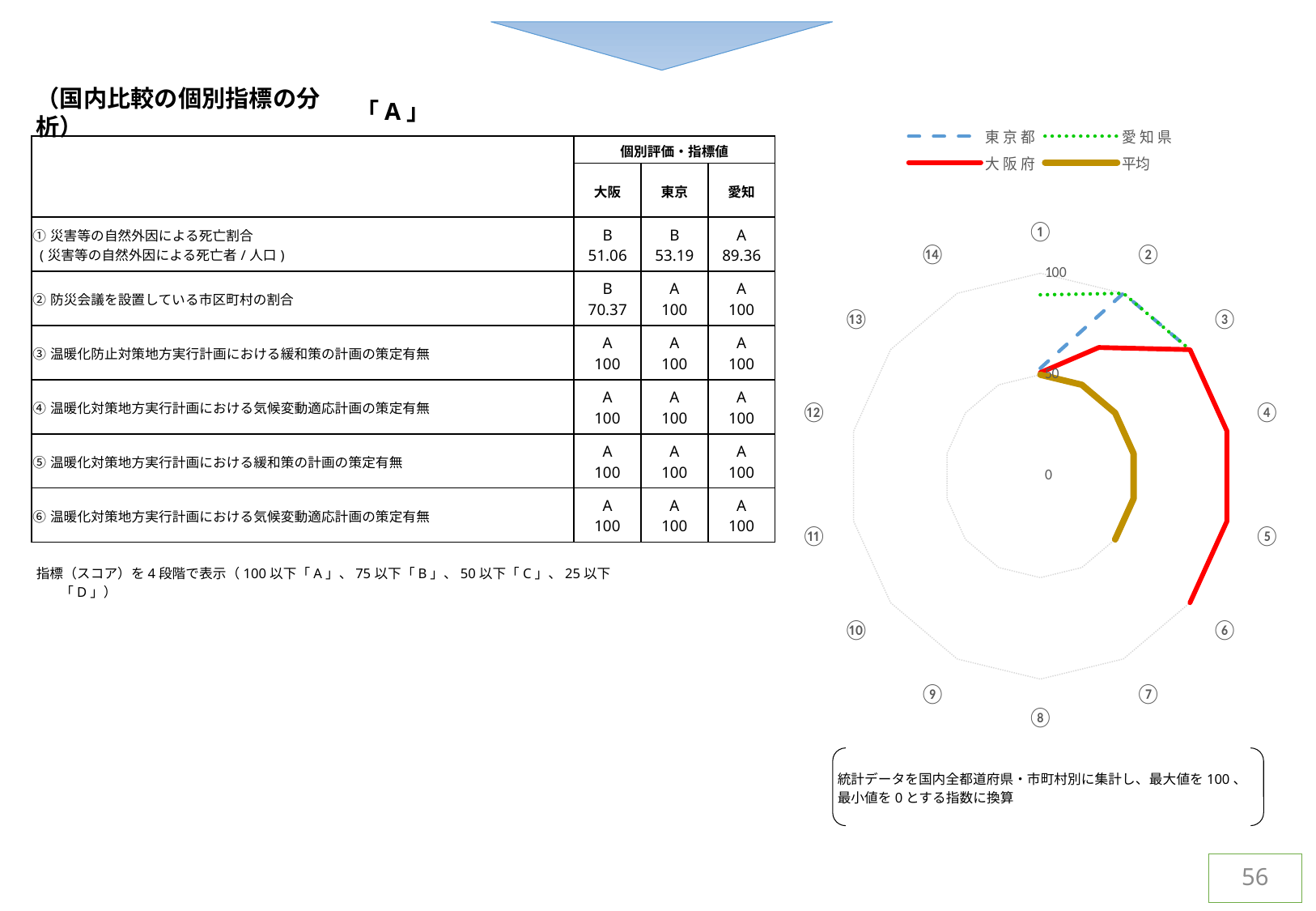
Which series in the radar chart is drawn as a blue dashed line? 東京都 Which series in the radar chart is drawn as a solid red line? 大阪府 Is the value for 東京都 at category ② in the radar chart greater or less than 50? greater Is the value for 大阪府 at category ⑤ in the radar chart greater or less than 50? greater How many series does the legend of the radar chart list? 4 Is the value for 大阪府 at category ④ in the radar chart greater or less than 50? greater In the radar chart, which is larger at category ③: the value for 大阪府 or the value for 平均? 大阪府 What kind of chart is shown on the right side of the slide? radar chart How many numbered categories are arranged around the radar chart? 14 What is the maximum value shown on the radar chart's axis? 100 In the radar chart, which is larger at category ⑤: the value for 大阪府 or the value for 平均? 大阪府